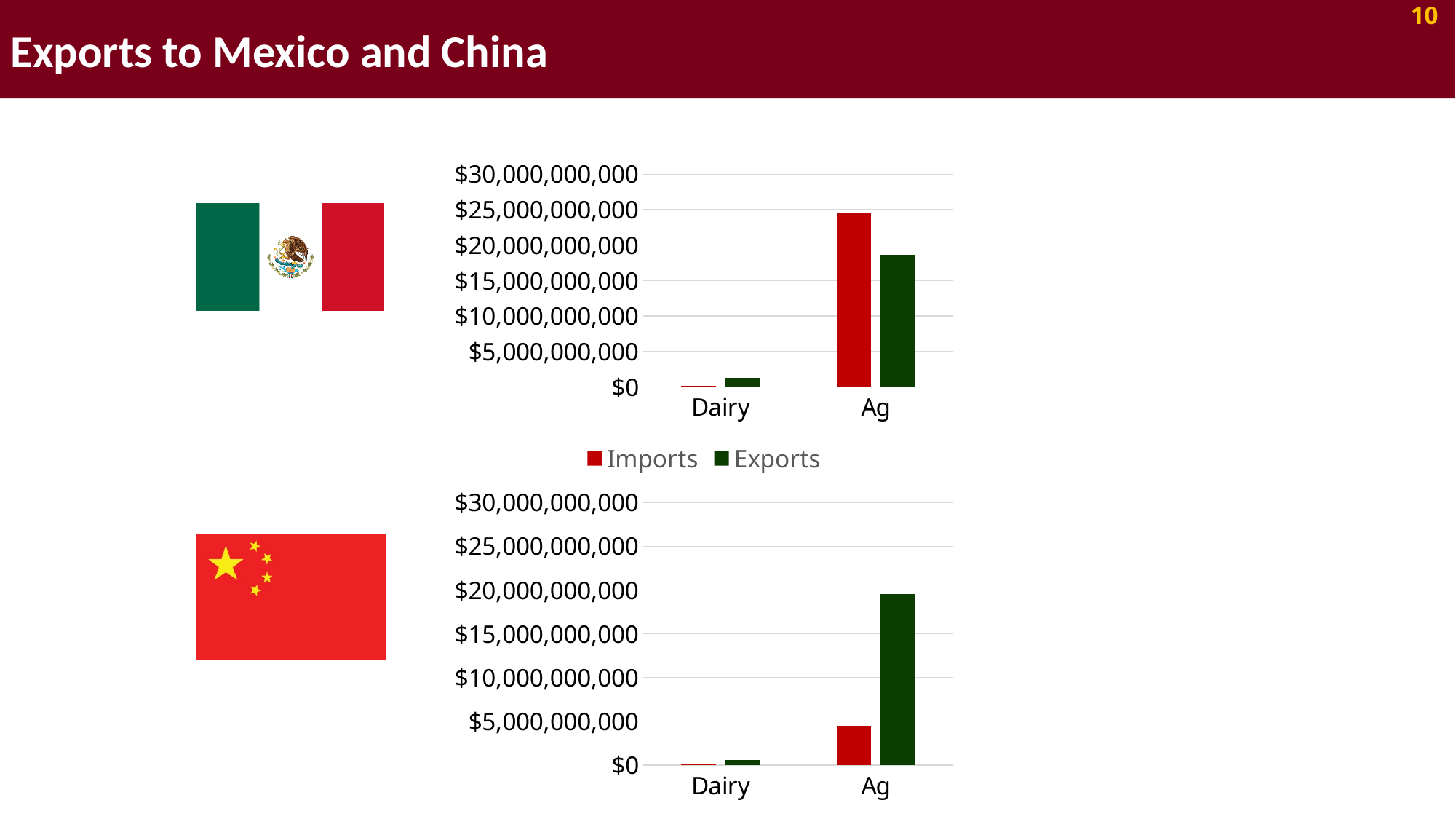
How many series does the legend list for the charts? 2 In the bottom chart next to the Chinese flag, is the Exports value for Ag greater or less than $15,000,000,000? greater In the top chart next to the Mexican flag, which is larger for Ag: Imports or Exports? Imports In the bottom chart next to the Chinese flag, is the Imports value for Ag greater or less than $5,000,000,000? less In the top chart next to the Mexican flag, which category has the lowest Imports value? Dairy What colour are the Exports bars in the charts? dark green In the top chart next to the Mexican flag, is the Exports value for Ag greater or less than $20,000,000,000? less How many categories are shown on the x axis of the bottom chart next to the Chinese flag? 2 In the bottom chart next to the Chinese flag, which is larger for Ag: Imports or Exports? Exports What kind of chart is the top chart next to the Mexican flag? bar chart In the bottom chart next to the Chinese flag, which category has the highest Exports value? Ag